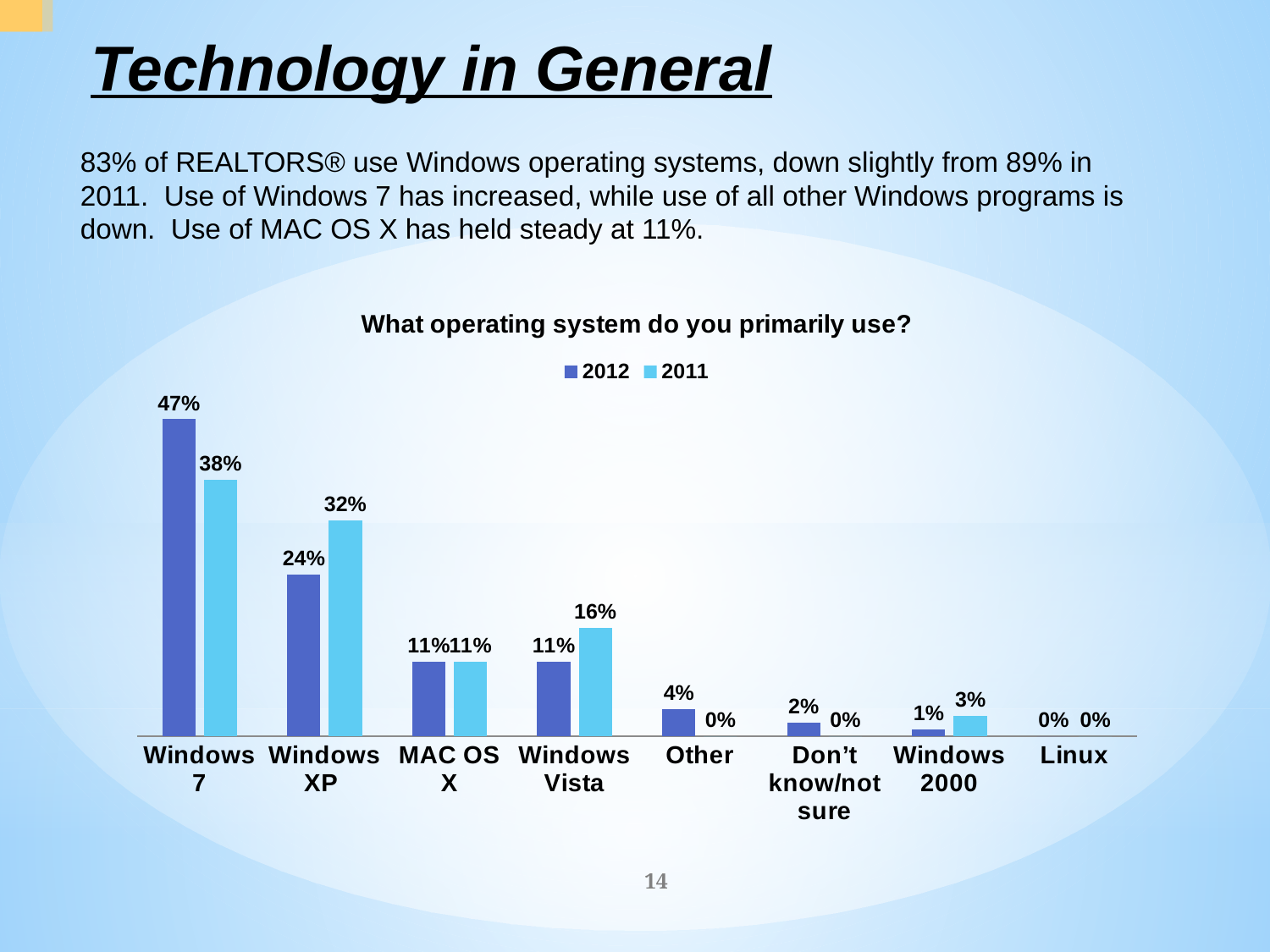
What is the difference between the 2012 and 2011 values for Windows 7? 9% What is the 2011 value for Windows XP? 32% What is the 2012 value for Windows 7? 47% Which category has the highest 2012 value? Windows 7 Which is larger for Windows Vista, the 2012 value or the 2011 value? 2011 What is the title of the chart? What operating system do you primarily use? What is the 2011 value for Windows Vista? 16% How many series does the legend list? 2 How many categories are shown on the x axis? 8 What is the difference between the 2011 and 2012 values for Windows XP? 8% Which category has the highest 2011 value? Windows 7 What kind of chart is shown? Bar chart